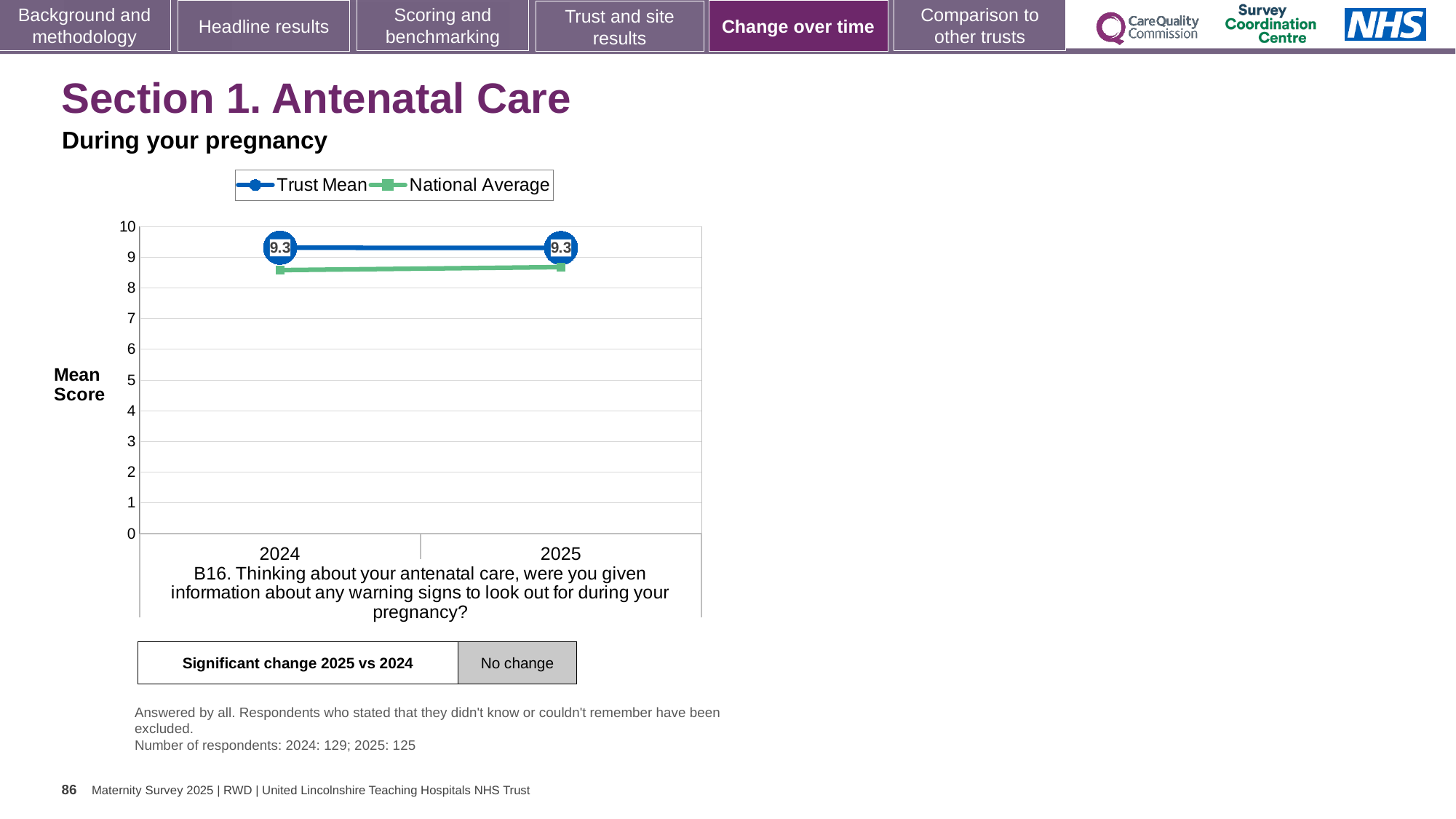
How many years are plotted on the x axis? 2 What are the two series named in the legend? Trust Mean and National Average Does the Trust Mean rise, fall or stay the same from 2024 to 2025? Stays the same In 2024, which is larger: the Trust Mean or the National Average? Trust Mean What is the label on the y axis of the chart? Mean Score Is the National Average value for 2025 greater or less than 8? greater Is the National Average value for 2024 greater or less than 9? less What is the difference between the Trust Mean in 2025 and the Trust Mean in 2024? 0 What is the Trust Mean value for 2025? 9.3 How many series does the legend list? 2 What kind of chart is shown on the slide? Line chart What is the Trust Mean value for 2024? 9.3